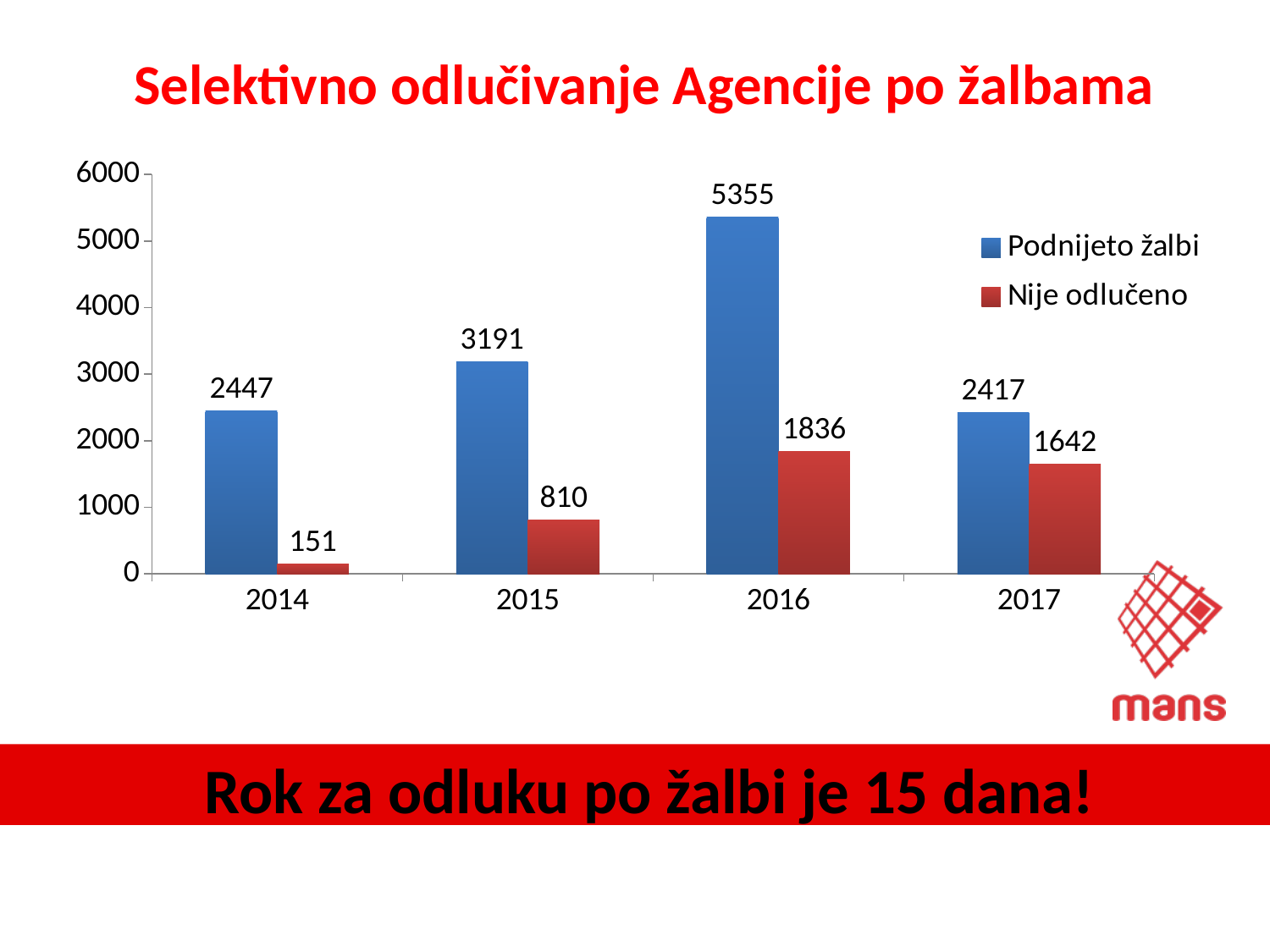
Which year has the highest value for Podnijeto žalbi? 2016 What is the value of Podnijeto žalbi for 2016? 5355 Which year has the lowest value for Nije odlučeno? 2014 What is the difference between Nije odlučeno in 2017 and in 2015? 832 What is the value of Nije odlučeno for 2014? 151 How many series does the legend list? 2 Which is larger: Podnijeto žalbi in 2015 or Podnijeto žalbi in 2017? Podnijeto žalbi in 2015 What is the value of Nije odlučeno for 2017? 1642 What is the difference between Podnijeto žalbi and Nije odlučeno in 2016? 3519 What kind of chart is shown on the slide? bar chart What is the title of the chart on the slide? Selektivno odlučivanje Agencije po žalbama How many years are shown on the x axis? 4